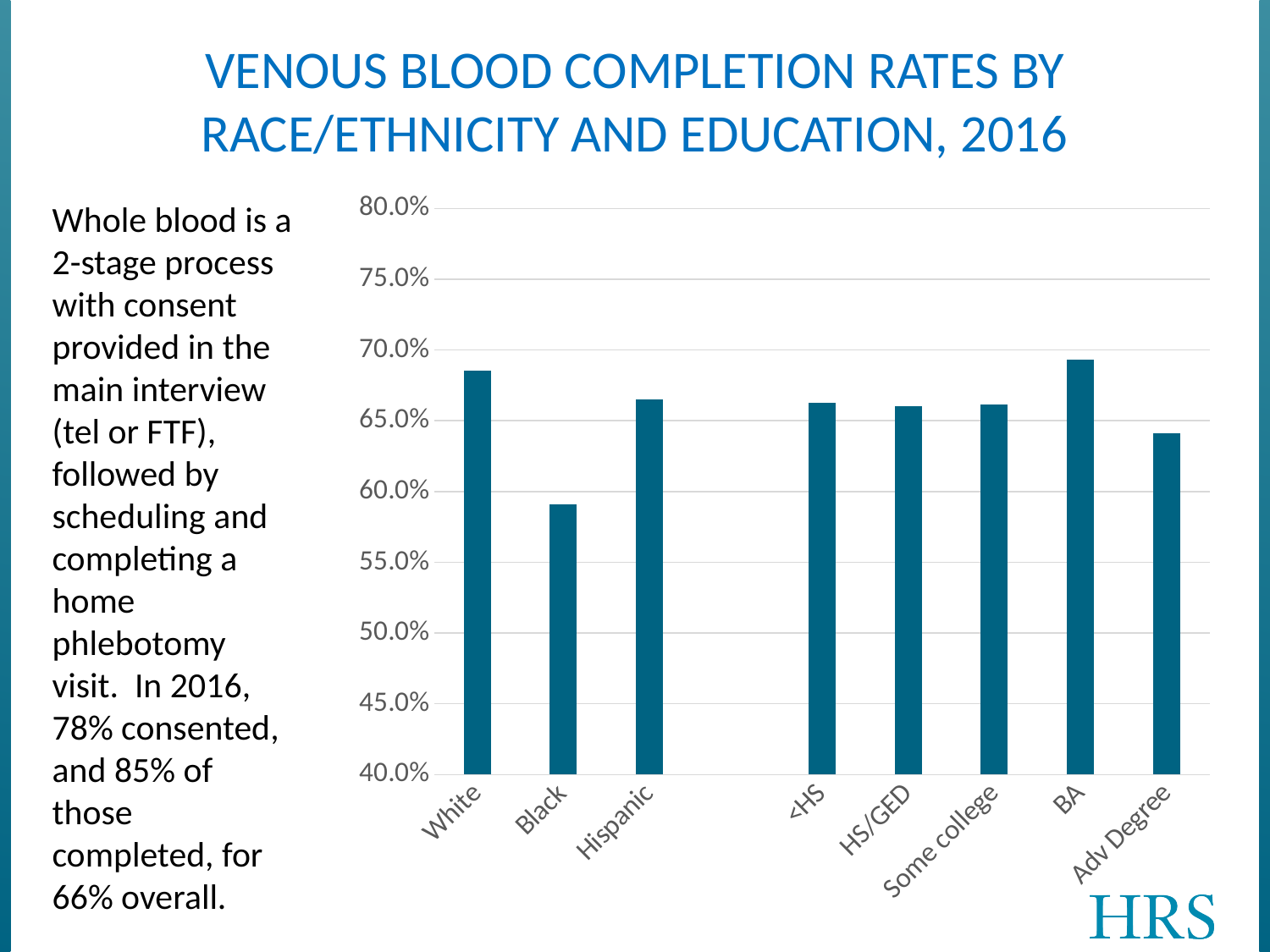
Which has the larger completion rate, BA or Adv Degree? BA Which category has the highest venous blood completion rate? BA Is the value for BA greater or less than 70.0%? less Which category has the lowest venous blood completion rate? Black Is the value for White greater or less than 65.0%? greater Is the value for Black greater or less than 60.0%? less What kind of chart is shown on the slide? bar chart Which has the larger completion rate, Black or Adv Degree? Adv Degree How many categories are plotted on the x axis of the chart? 8 Which has the larger completion rate, White or Black? White What is the title of the chart on the slide? VENOUS BLOOD COMPLETION RATES BY RACE/ETHNICITY AND EDUCATION, 2016